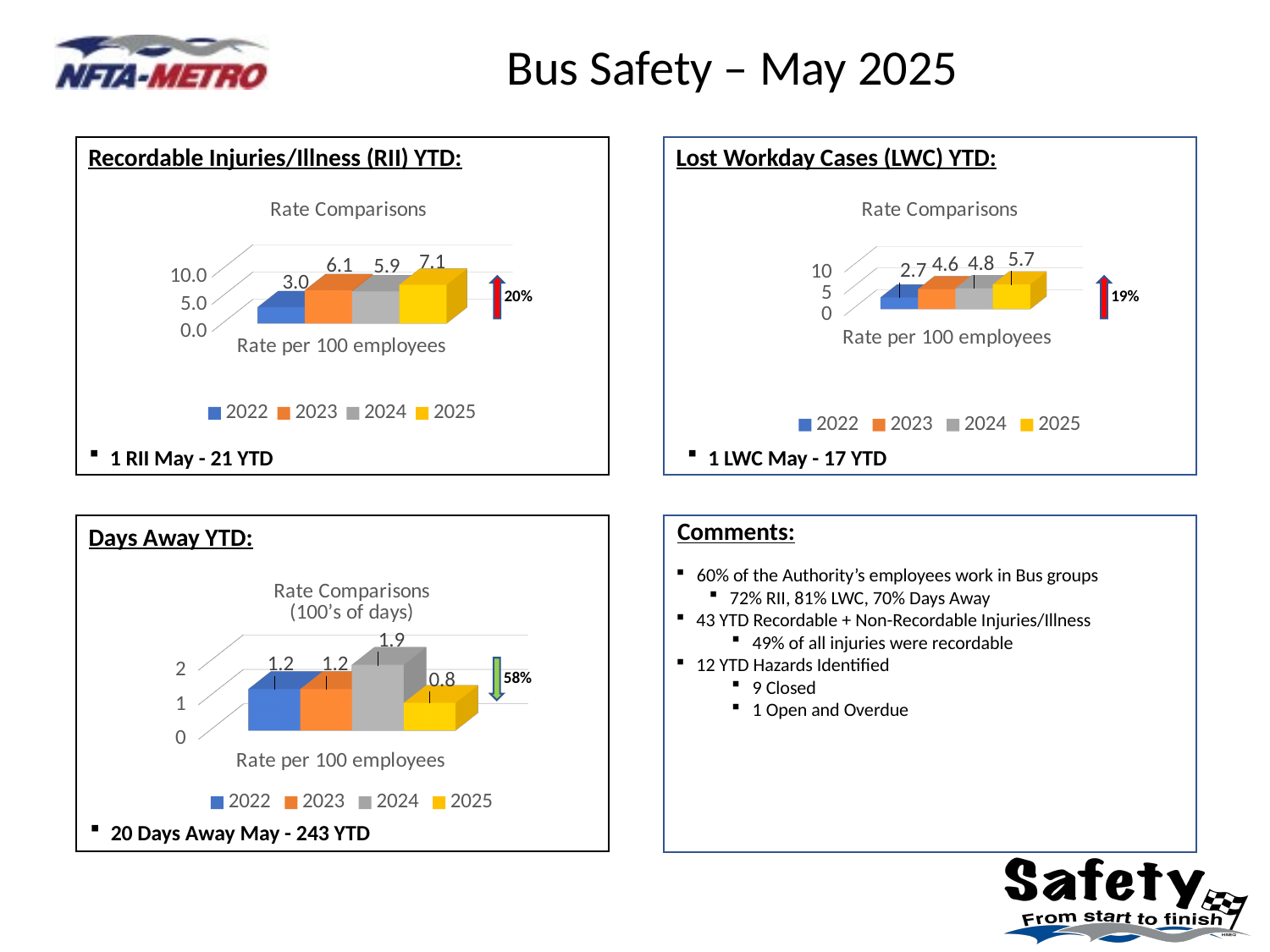
In the Days Away YTD chart, which year has the lowest rate? 2025 In the Lost Workday Cases (LWC) YTD chart, what is the rate per 100 employees for 2023? 4.6 In the Days Away YTD chart, what is the difference between the 2024 rate and the 2025 rate? 1.1 In the Recordable Injuries/Illness (RII) YTD chart, which year has the lowest rate? 2022 In the Recordable Injuries/Illness (RII) YTD chart, what is the difference between the 2025 rate and the 2022 rate? 4.1 In the Recordable Injuries/Illness (RII) YTD chart, what is the rate per 100 employees for 2025? 7.1 In the Lost Workday Cases (LWC) YTD chart, which year has the highest rate? 2025 How many series does the legend list in the Lost Workday Cases (LWC) YTD chart? 4 What kind of chart is the Recordable Injuries/Illness (RII) YTD chart? Bar chart In the Days Away YTD chart, what is the rate per 100 employees for 2024? 1.9 In the Days Away YTD chart, is the 2024 rate larger or the 2025 rate larger? 2024 In the Lost Workday Cases (LWC) YTD chart, is the 2025 rate greater or less than 5? greater